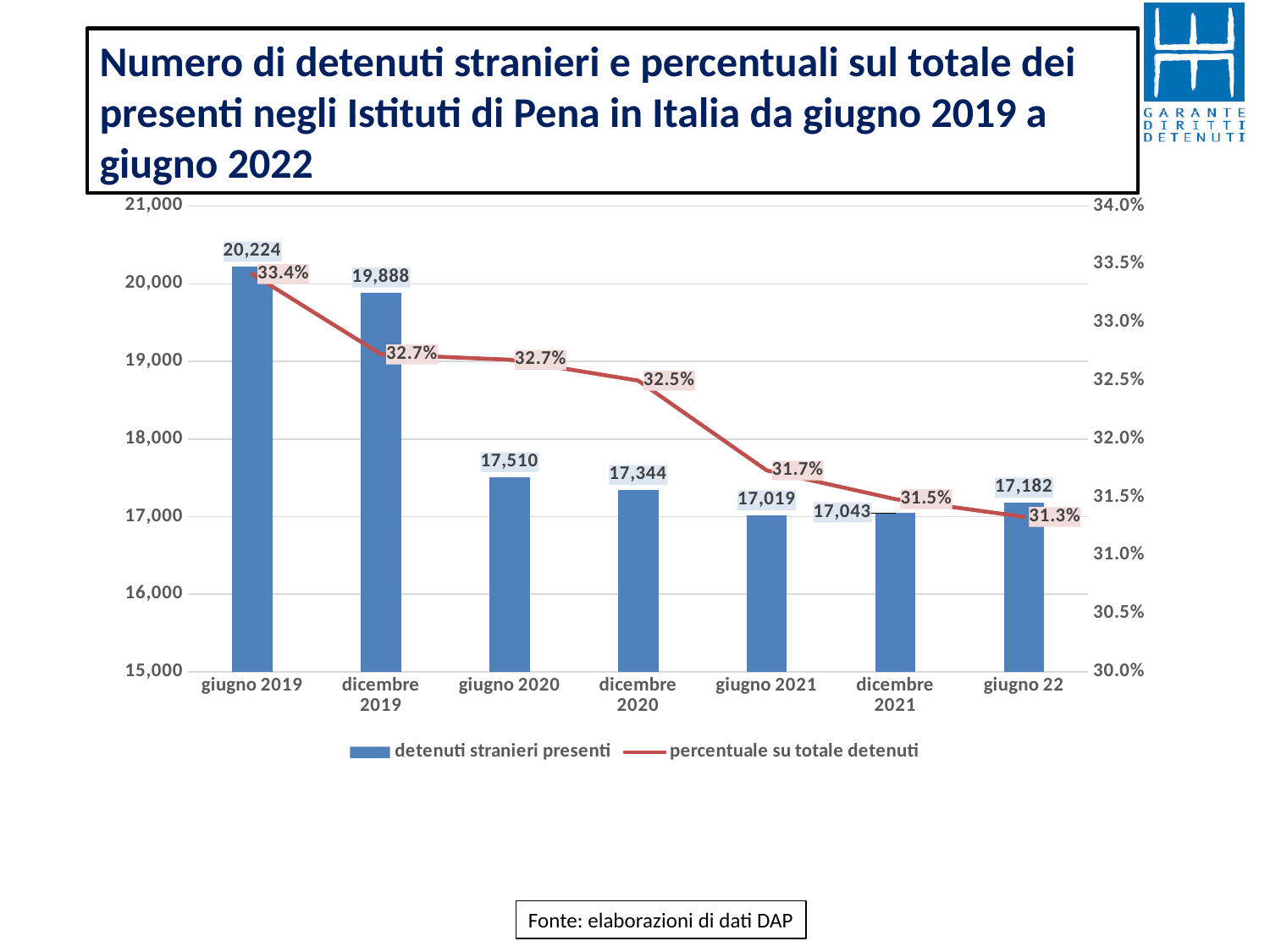
What is the difference in 'detenuti stranieri presenti' between giugno 2019 and dicembre 2019? 336 What is the value of 'detenuti stranieri presenti' for dicembre 2021? 17,043 Which is larger, the number of 'detenuti stranieri presenti' in giugno 2020 or in giugno 22? giugno 2020 How many series does the legend list? 2 Which period has the highest number of 'detenuti stranieri presenti'? giugno 2019 Is the 'percentuale su totale detenuti' for dicembre 2020 greater or less than 32.0%? greater What is the 'percentuale su totale detenuti' for giugno 22? 31.3% Which period has the lowest number of 'detenuti stranieri presenti'? giugno 2021 Does the 'percentuale su totale detenuti' line rise or fall from giugno 2019 to giugno 22? fall How many periods are shown on the x axis? 7 What kind of chart is used for the 'detenuti stranieri presenti' series? bar chart What is the value of 'detenuti stranieri presenti' for giugno 2019? 20,224